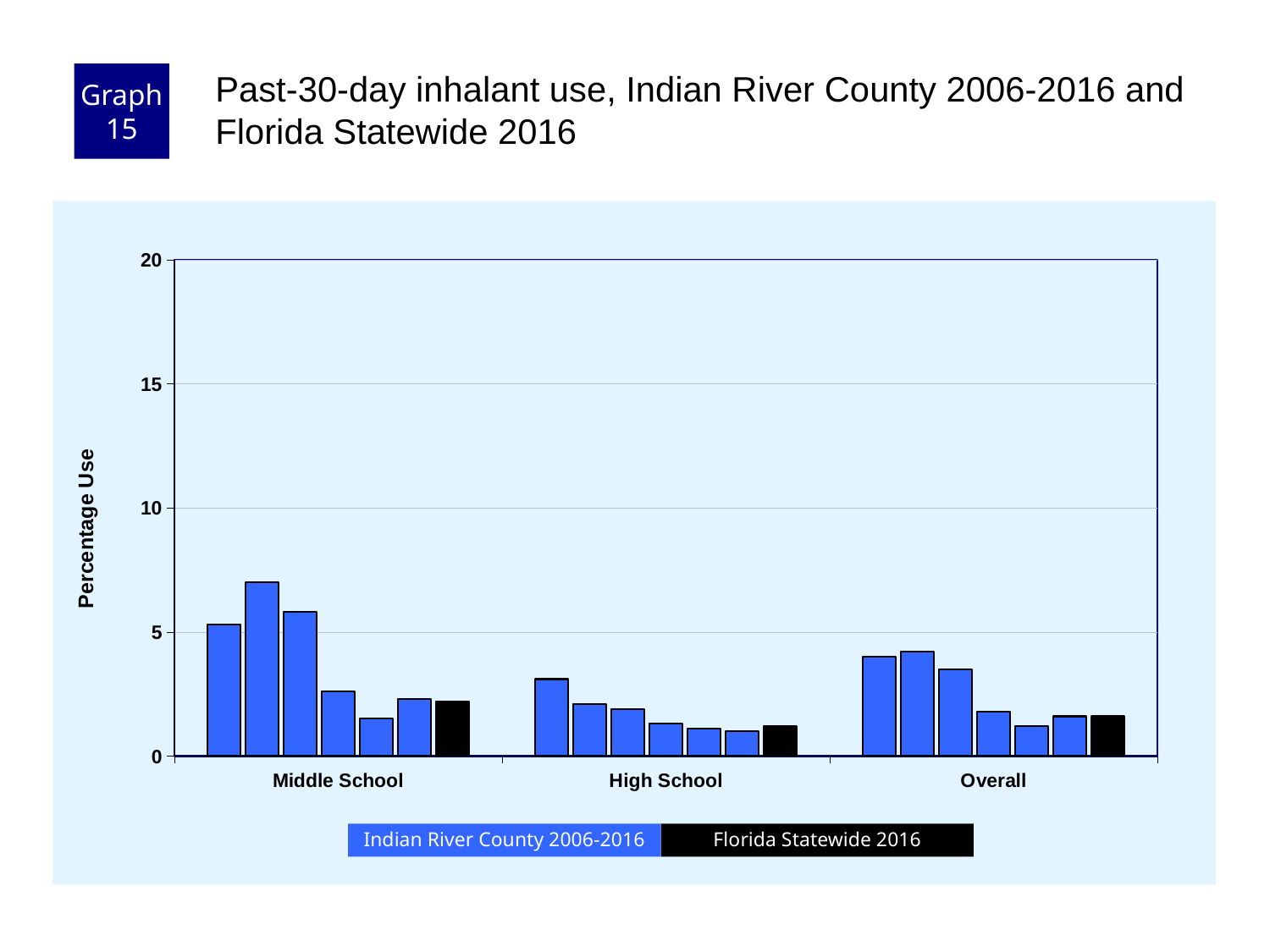
Which series is shown in black in the legend? Florida Statewide 2016 Is the tallest bar in the High School group greater or less than 5? less Which category contains the tallest bar on the chart? Middle School Which is larger, the Florida Statewide 2016 value for Middle School or for High School? Middle School How many bars are plotted in the Middle School group? 7 How many categories are shown on the x axis? 3 Is the tallest bar in the Middle School group greater or less than 10? less How many series does the legend list? 2 What kind of chart is shown on the slide? bar chart Which is larger, the tallest Indian River County 2006-2016 bar for Middle School or the tallest for Overall? Middle School What is the label on the y axis? Percentage Use Is the Florida Statewide 2016 value for Overall greater or less than 5? less